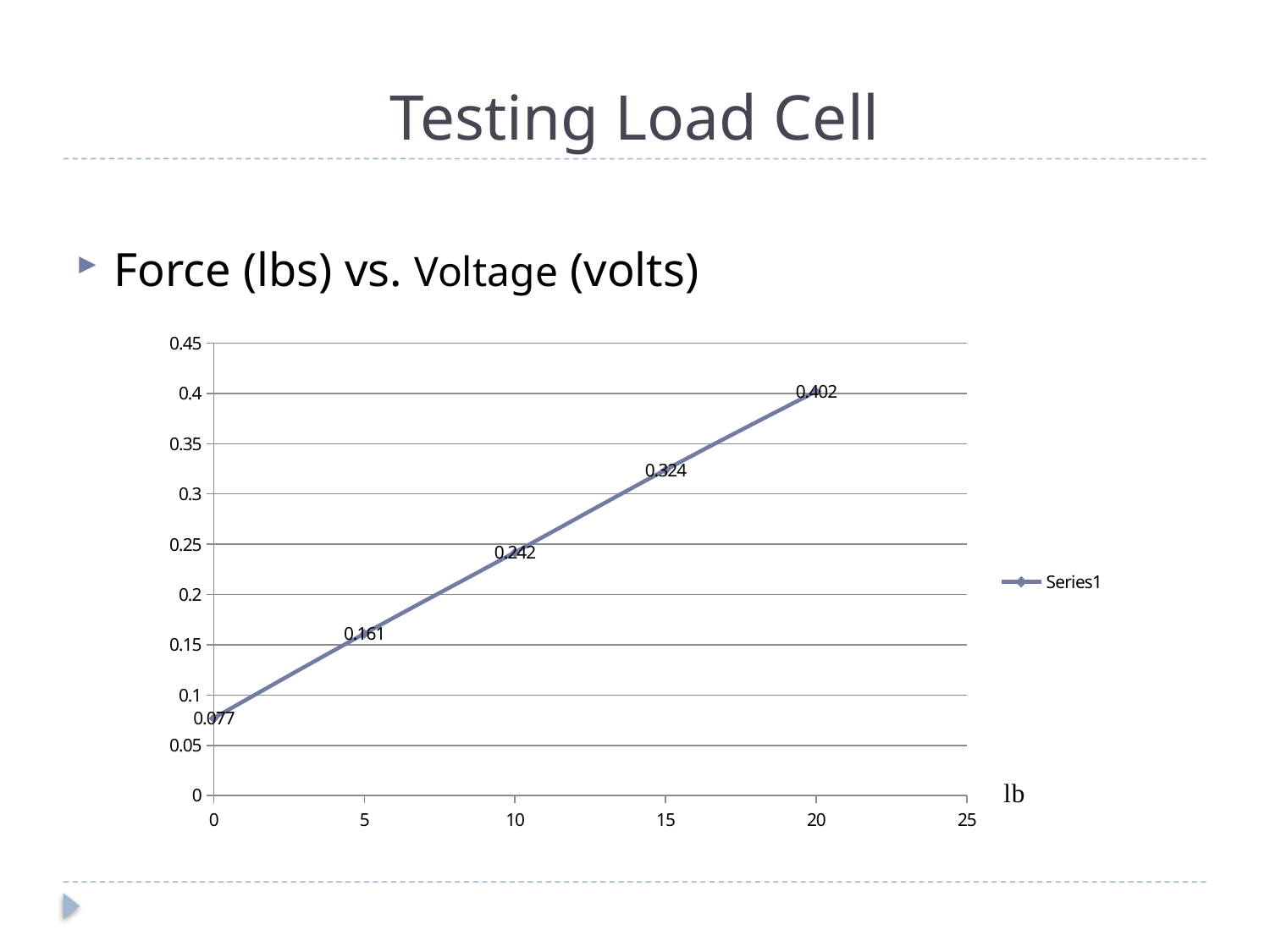
What is the difference between the values at 20 lb and 0 lb? 0.325 Do the plotted values rise or fall as force increases along the x axis? rise What series name does the legend show? Series1 What is the voltage value at 15 lb? 0.324 What is the voltage value at 0 lb? 0.077 At which force (lb) is the plotted value highest? 20 At which force (lb) is the plotted value lowest? 0 What kind of chart is shown on the slide? line chart What is the voltage value at 5 lb? 0.161 What is the voltage value at 10 lb? 0.242 How many data points are plotted on the chart? 5 What is the voltage value at 20 lb? 0.402